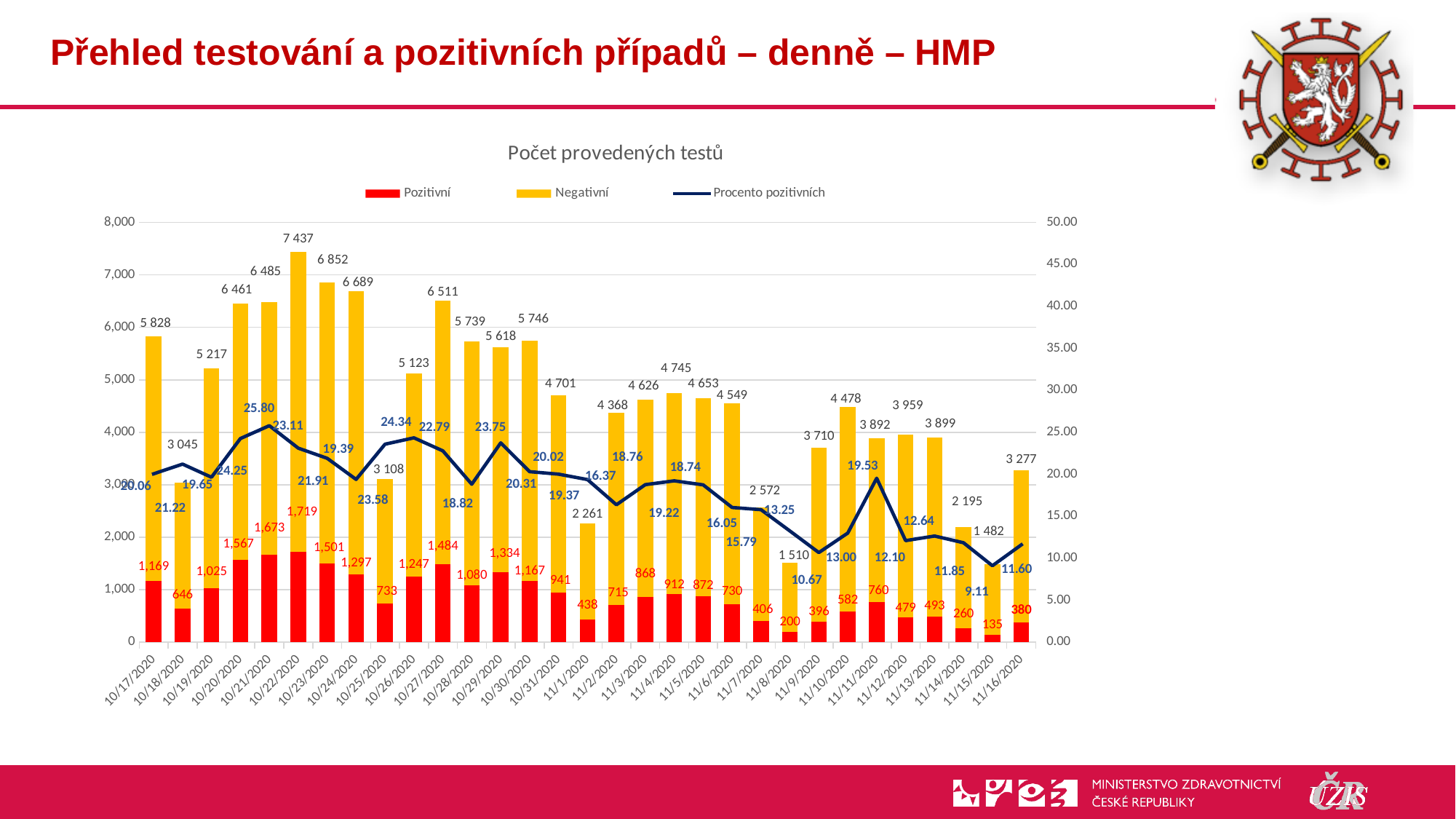
Which legend entry is represented by the dark line? Procento pozitivních On which date is the Pozitivní value the lowest? 11/15/2020 What kind of chart is shown on the slide? Bar chart (stacked bars with a line) How many dates are shown on the x axis? 31 What is the Pozitivní value for 10/22/2020? 1,719 On which date is the total bar the highest? 10/22/2020 What is the difference between the Pozitivní values for 10/22/2020 and 10/21/2020? 46 What is the Procento pozitivních value for 10/21/2020? 25.80 What is the total label shown above the bar for 11/16/2020? 3 277 On which date is the Procento pozitivních value the lowest? 11/15/2020 How many series does the legend list? 3 Which date has the larger Pozitivní value, 10/19/2020 or 10/20/2020? 10/20/2020